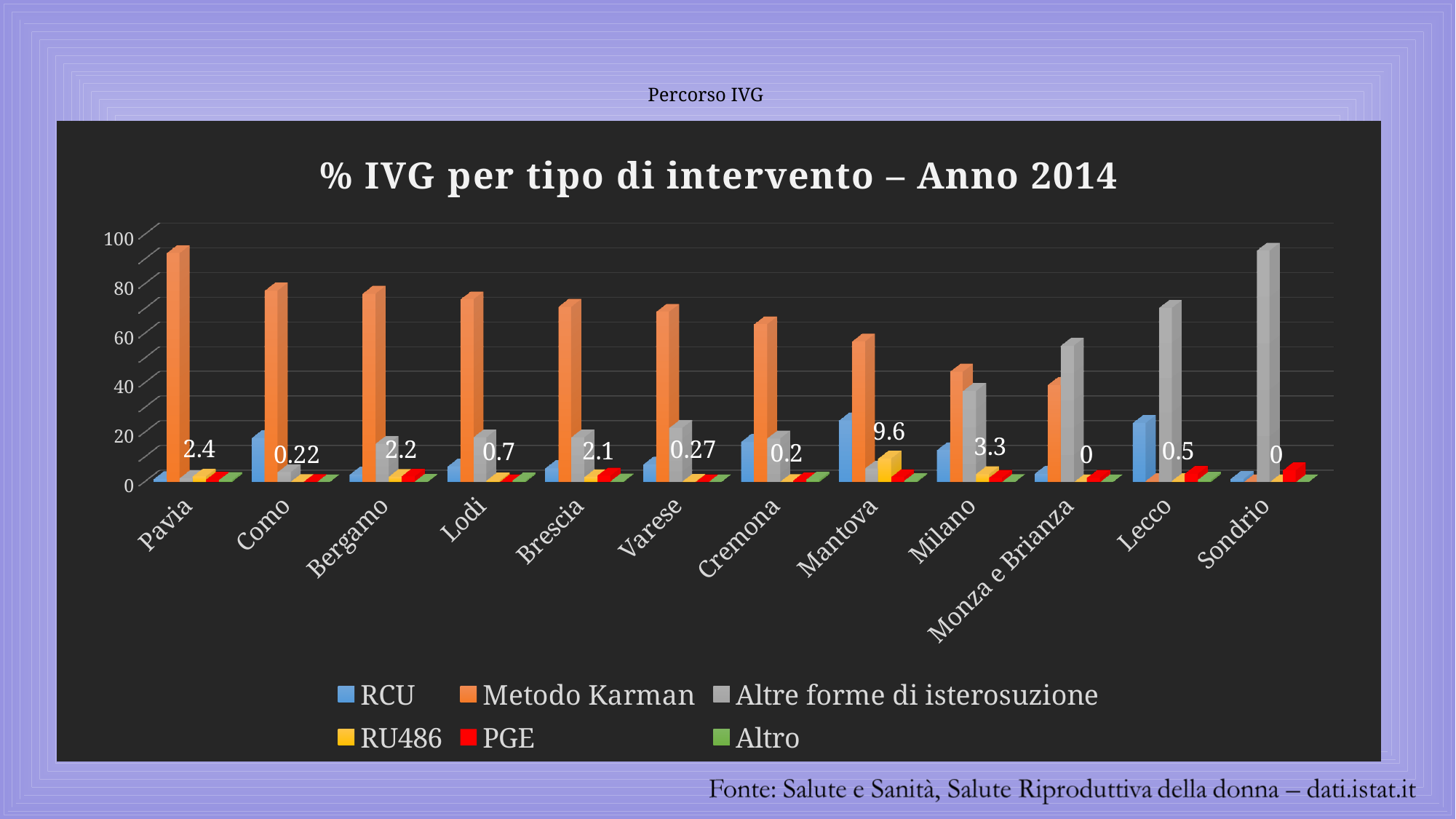
What kind of chart is shown on the slide? Bar chart Which has a larger RU486 value, Pavia or Bergamo? Pavia What is the difference between the RU486 values for Mantova and Milano? 6.3 What is the RU486 value for Como? 0.22 What is the RU486 value for Milano? 3.3 Is the Metodo Karman value for Pavia greater or less than 80? greater How many series does the legend list? 6 Is the Altre forme di isterosuzione value for Sondrio greater or less than 80? greater How many provinces are shown on the x axis? 12 Which province has the highest RU486 value? Mantova What is the RU486 value for Mantova? 9.6 What is the RU486 value for Lecco? 0.5